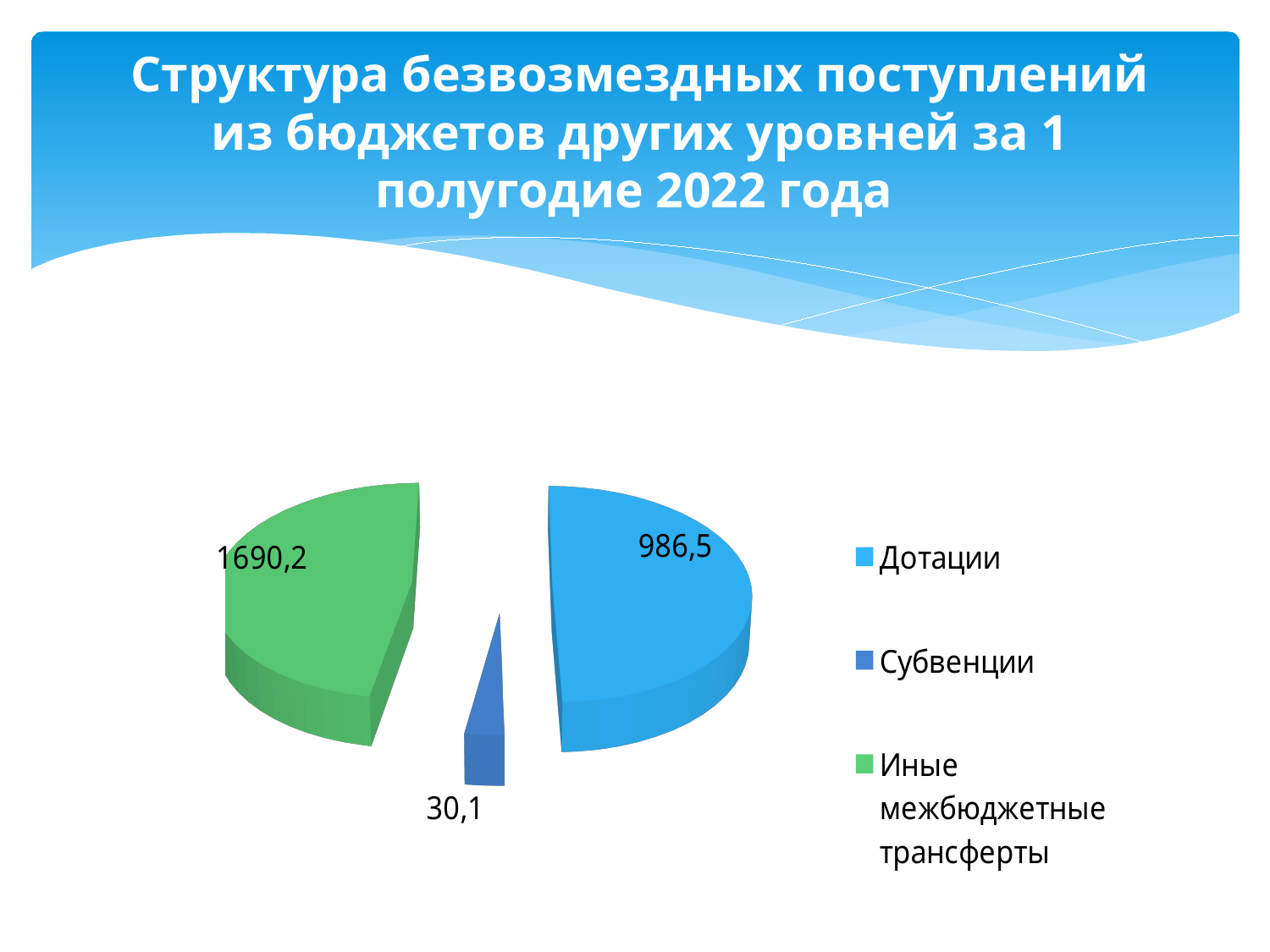
What is the difference between Дотации and Субвенции? 956,4 What kind of chart is shown on the slide? Pie chart What is the value for Дотации? 986,5 Which is larger, Дотации or Субвенции? Дотации What is the value for Иные межбюджетные трансферты? 1690,2 What colour is the slice for Иные межбюджетные трансферты? Green How many slices does the pie chart have? 3 Which category has the smallest slice of the pie? Субвенции What is the total of all three slices? 2706,8 What is the difference between Иные межбюджетные трансферты and Дотации? 703,7 What is the value for Субвенции? 30,1